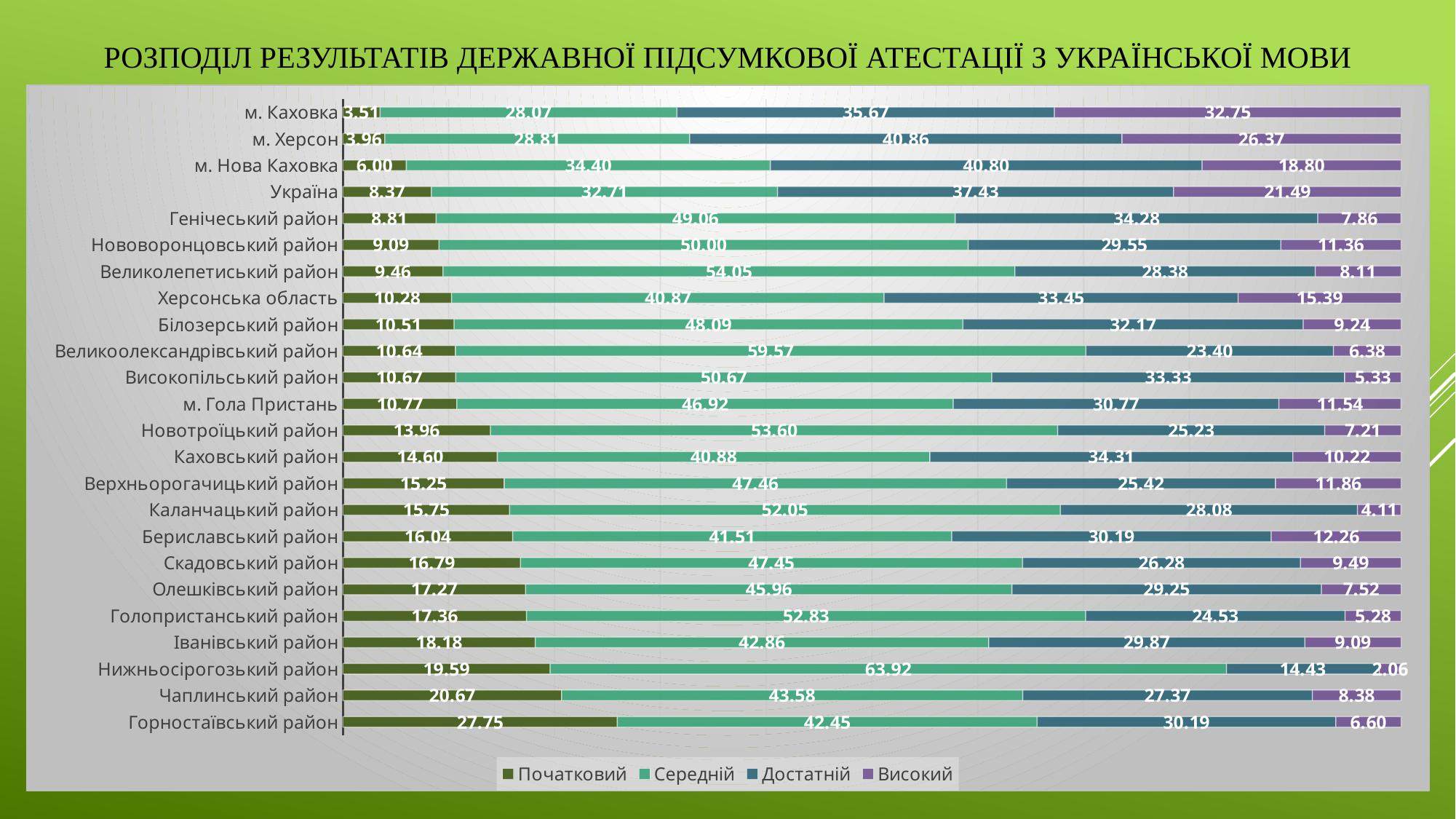
Which category has the lowest value in the Високий series? Нижньосірогозький район What is the value of the Середній series for Нижньосірогозький район? 63.92 Which has the larger Середній value: Великоолександрівський район or Новотроїцький район? Великоолександрівський район Which category has the highest value in the Початковий series? Горностаївський район How many series does the legend list? 4 What are the series names listed in the legend? Початковий, Середній, Достатній, Високий How many categories are shown on the chart? 24 What is the value of the Високий series for м. Каховка? 32.75 What is the value of the Достатній series for Херсонська область? 33.45 Which category has the lowest value in the Початковий series? м. Каховка What is the difference between the Високий values for Україна and Херсонська область? 6.10 What kind of chart is shown on the slide? Stacked bar chart